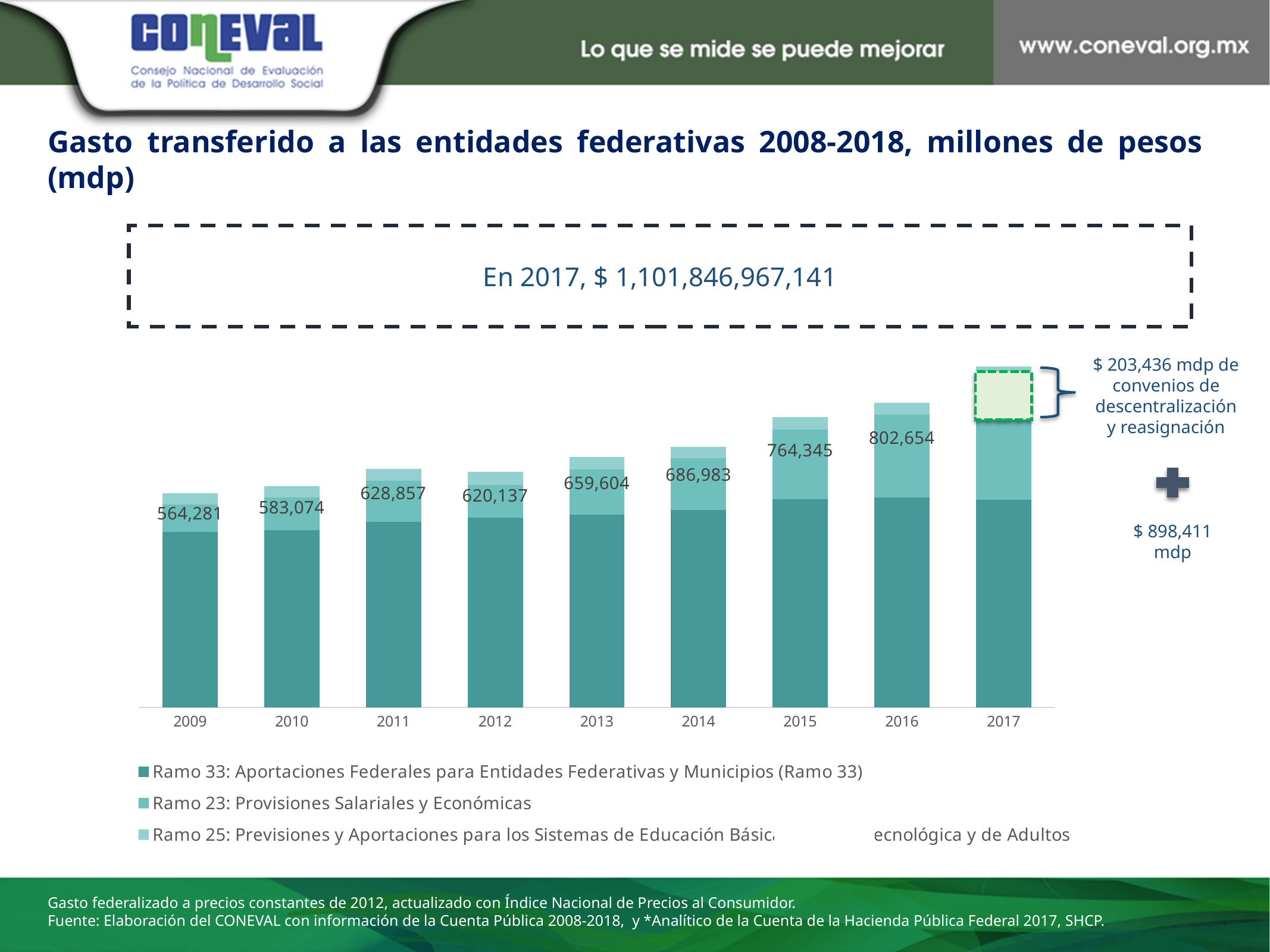
Which year has the larger labelled value, 2011 or 2012? 2011 What value is labelled on the bar for 2009? 564,281 How many years are shown along the x axis of the chart? 9 What value is labelled on the bar for 2014? 686,983 Which year has the tallest bar in the chart? 2017 What is the difference between the labelled values for 2016 and 2015? 38,309 According to the annotation next to the 2017 bar, how many mdp come from convenios de descentralización y reasignación? $ 203,436 mdp What kind of chart is shown on the slide? Stacked bar chart Which year has the shortest bar in the chart? 2009 Do the bar values generally rise or fall from 2009 to 2017? Rise What value is labelled on the bar for 2016? 802,654 How many series does the chart's legend list? 3